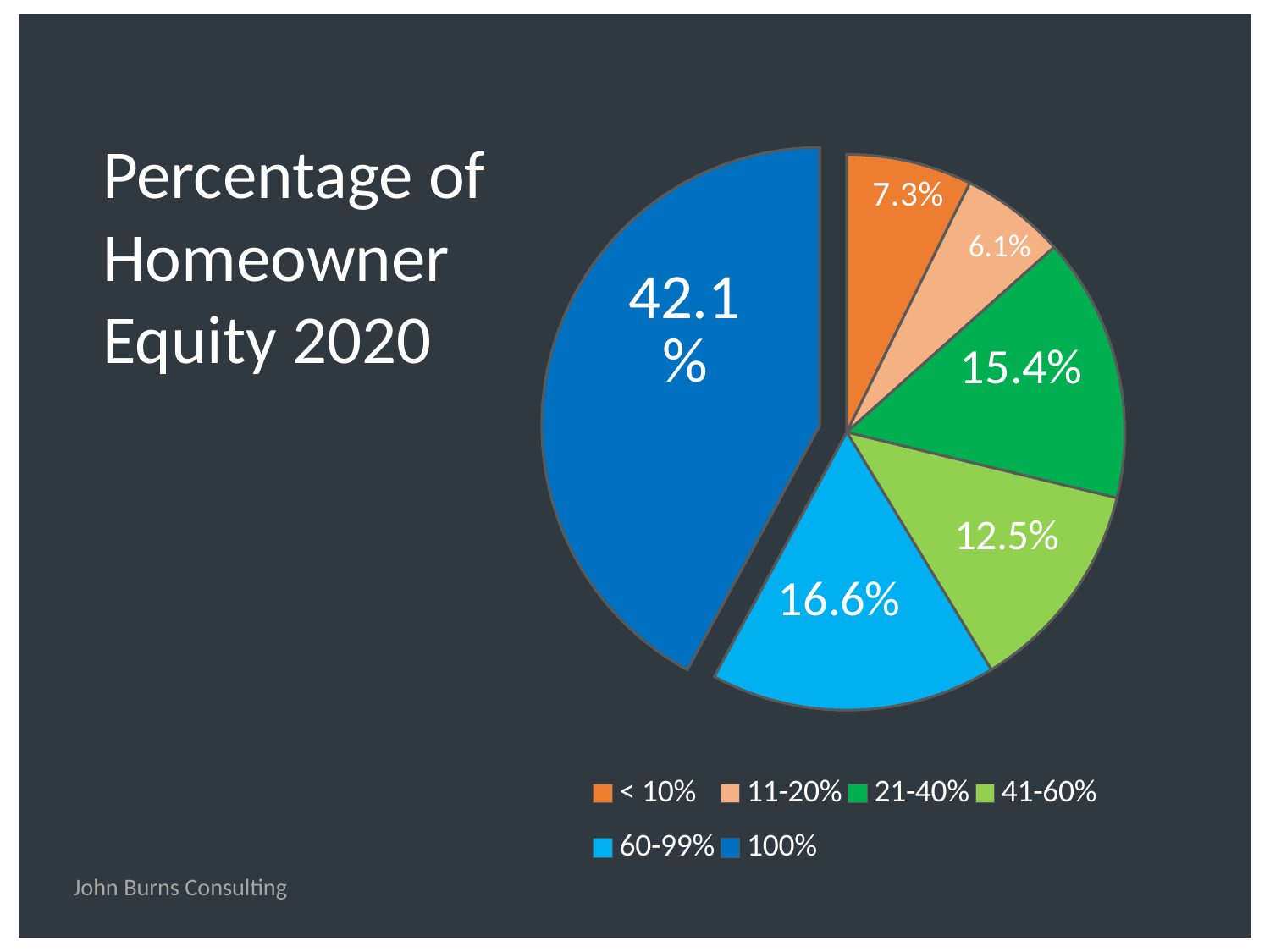
Which equity category has the largest share of the pie? 100% What is the title of the chart? Percentage of Homeowner Equity 2020 What is the difference between the 21-40% slice and the 41-60% slice? 2.9% How many slices does the pie chart have? 6 Which equity category has the smallest share of the pie? 11-20% What percentage of homeowners have less than 10% equity? 7.3% What colour is the 41-60% slice? light green What percentage of homeowners have 60-99% equity? 16.6% What kind of chart is shown on the slide? pie chart What percentage of homeowners have 21-40% equity? 15.4% What percentage of homeowners have 100% equity? 42.1% Which is larger, the 60-99% slice or the 21-40% slice? 60-99%